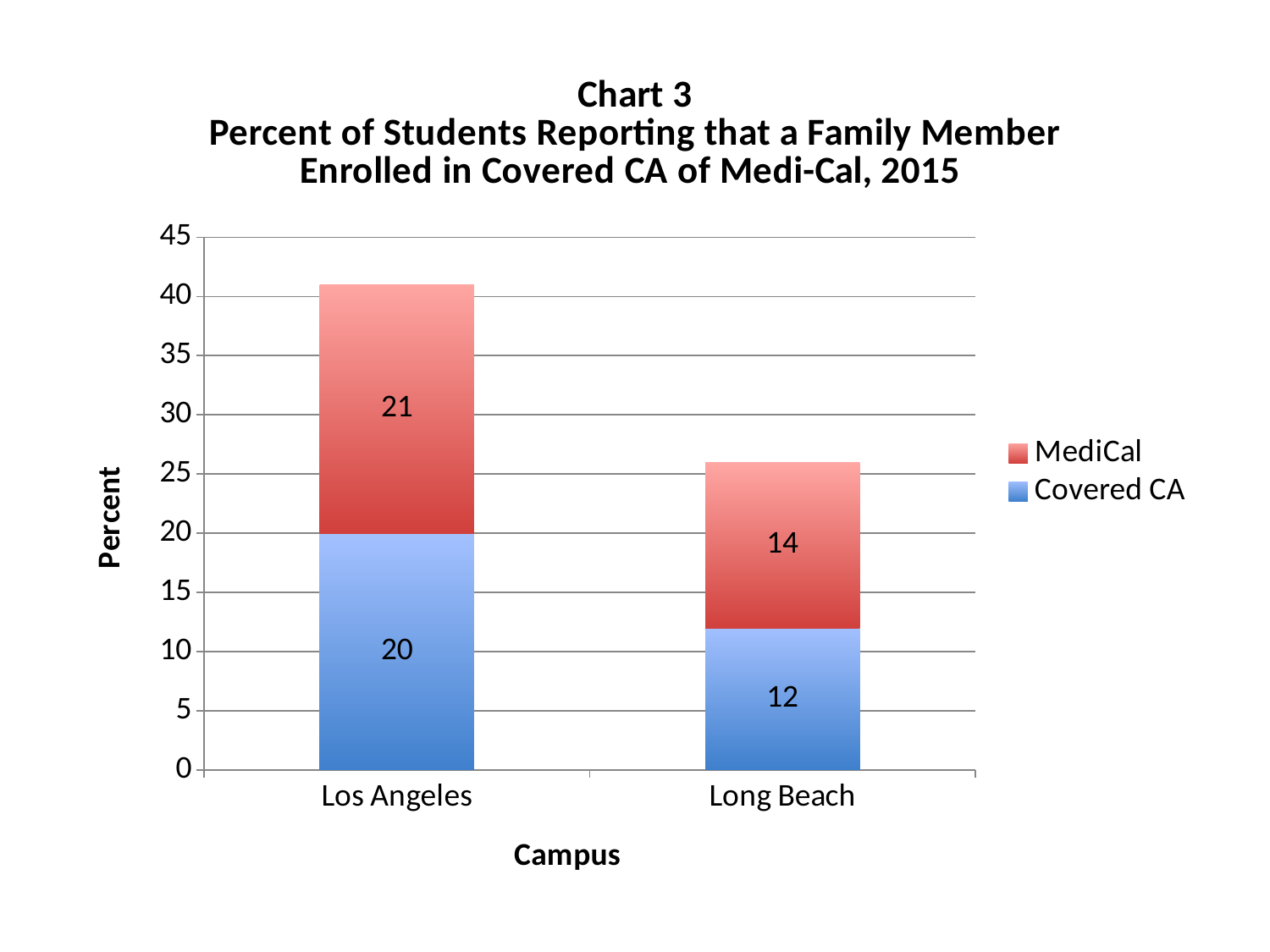
What is the difference between the Covered CA values for Los Angeles and Long Beach? 8 What is the MediCal value for Los Angeles? 21 Which campus has the higher Covered CA value? Los Angeles Is the MediCal value for Los Angeles or Long Beach larger? Los Angeles What is the total of the stacked bar for Los Angeles? 41 What is the Covered CA value for Long Beach? 12 What is the MediCal value for Long Beach? 14 How many campuses are shown on the x axis? 2 What is the total of the stacked bar for Long Beach? 26 Which campus has the lower MediCal value? Long Beach How many series does the legend list? 2 What is the Covered CA value for Los Angeles? 20